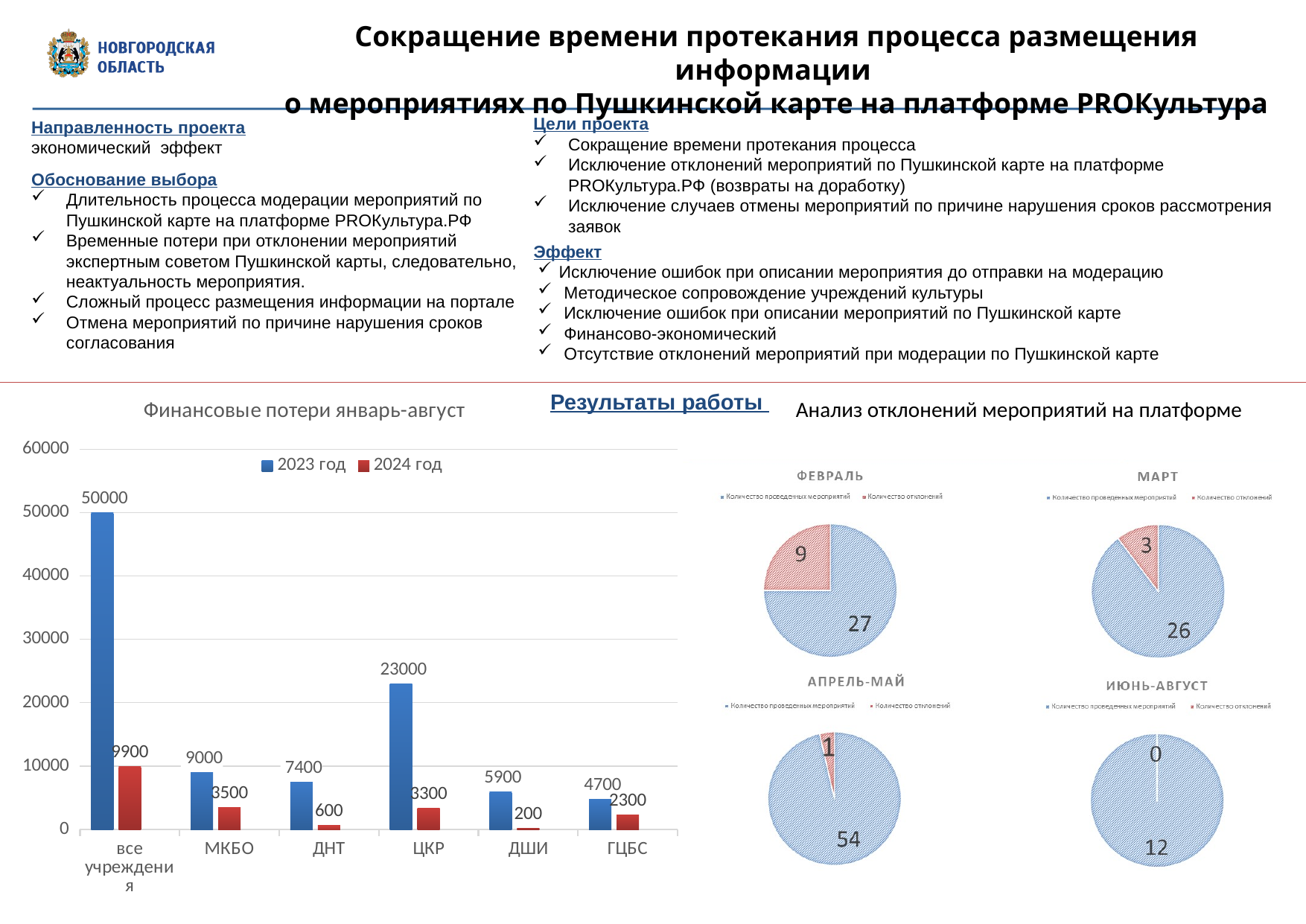
What type of chart is 'Финансовые потери январь-август'? bar chart In the chart 'Финансовые потери январь-август', what is the value for 'ДНТ' in the '2023 год' series? 7400 How many series does the legend of the chart 'Финансовые потери январь-август' list? 2 In the chart 'Финансовые потери январь-август', which category has the lowest value in the '2024 год' series? ДШИ In the 'ФЕВРАЛЬ' pie chart under 'Анализ отклонений мероприятий на платформе', what is the value of the red (smaller) slice? 9 In the 'АПРЕЛЬ-МАЙ' pie chart under 'Анализ отклонений мероприятий на платформе', what is the value of the blue (larger) slice? 54 In the chart 'Финансовые потери январь-август', what is the difference between the '2023 год' and '2024 год' values for 'МКБО'? 5500 In the chart 'Финансовые потери январь-август', which is larger: the '2024 год' value for 'ГЦБС' or the '2024 год' value for 'ДНТ'? ГЦБС How many categories are shown on the x axis of the chart 'Финансовые потери январь-август'? 6 In the chart 'Финансовые потери январь-август', what is the value for 'все учреждения' in the '2023 год' series? 50000 In the chart 'Финансовые потери январь-август', what is the value for 'ЦКР' in the '2024 год' series? 3300 In the chart 'Финансовые потери январь-август', excluding 'все учреждения', which category has the highest value in the '2023 год' series? ЦКР